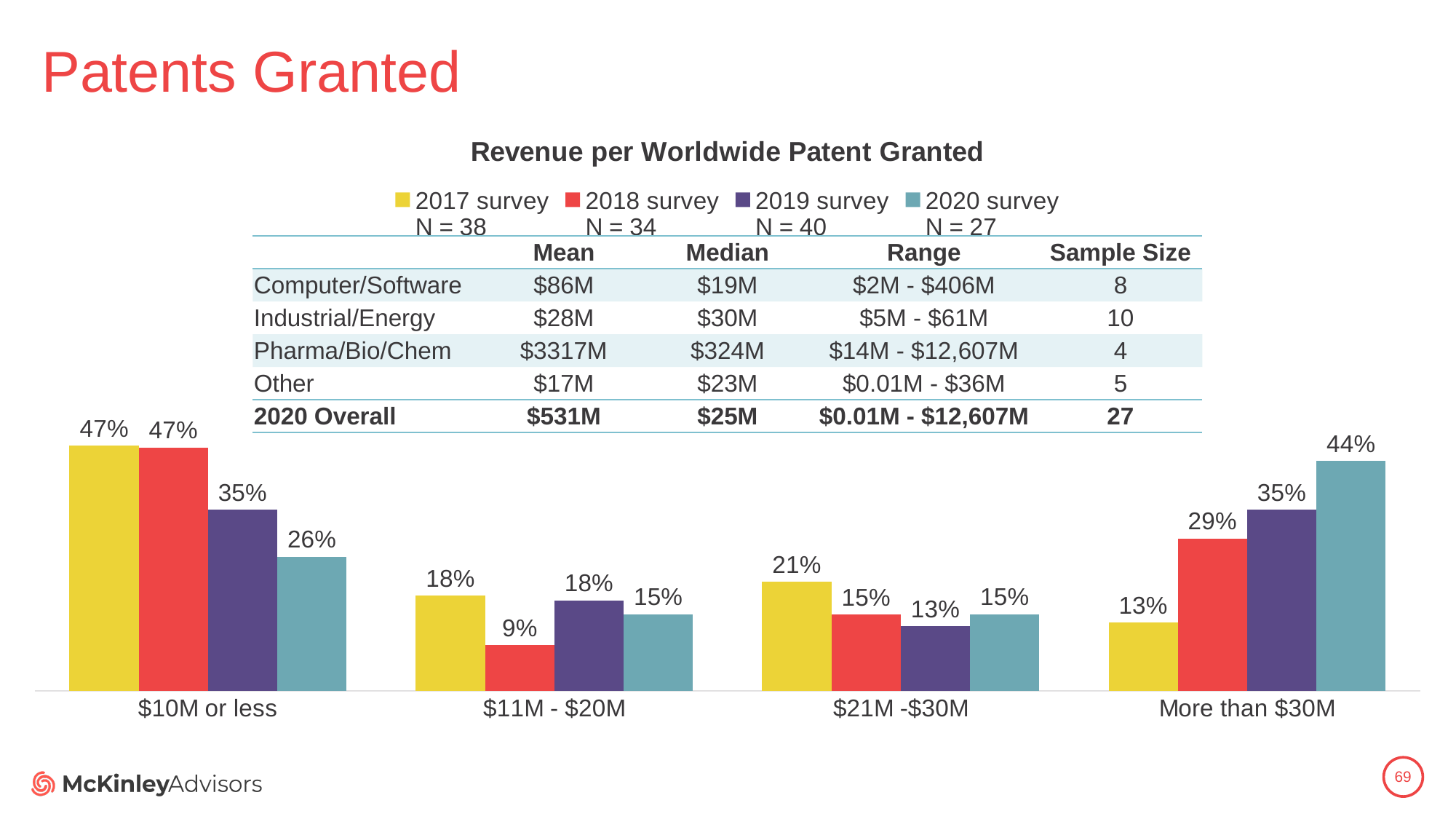
How many series does the chart legend list? 4 What is the value for the 2020 survey in the "More than $30M" category? 44% What is the difference between the 2017 survey and 2020 survey values in the "$10M or less" category? 21% Which category has the highest value for the 2017 survey? $10M or less What is the value for the 2019 survey in the "$10M or less" category? 35% What kind of chart is shown on the slide? Bar chart Do the 2020 survey values rise or fall from the "$21M -$30M" category to the "More than $30M" category? Rise Which category has the lowest value for the 2020 survey? $11M - $20M and $21M -$30M (tied at 15%) How many revenue categories are shown on the x axis of the chart? 4 What is the value for the 2018 survey in the "$11M - $20M" category? 9% What is the title of the chart? Revenue per Worldwide Patent Granted Which is larger in the "$21M -$30M" category: the 2017 survey value or the 2019 survey value? 2017 survey